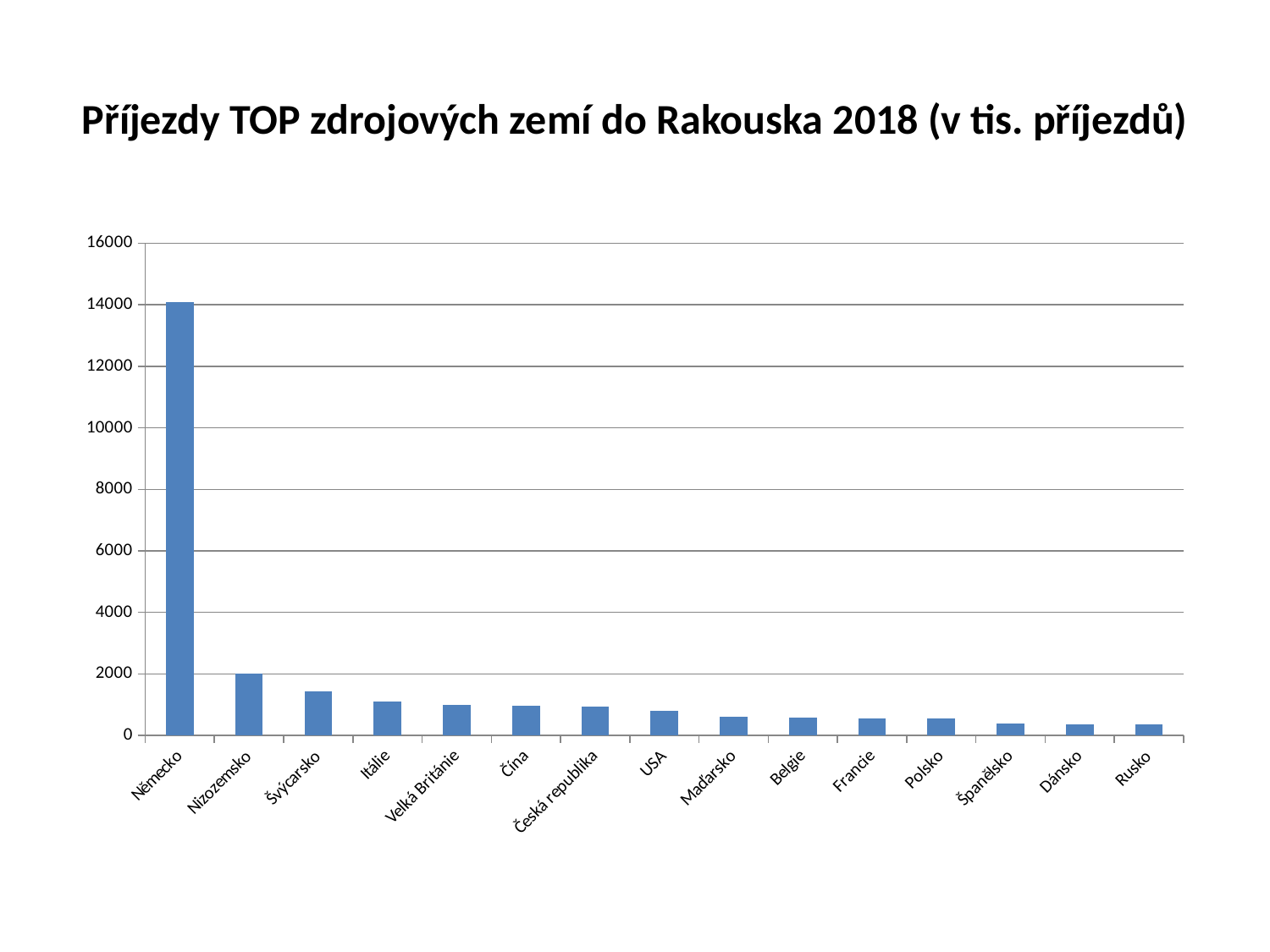
Is the value for Německo greater or less than 12000? greater Do the values generally rise or fall from left to right along the x axis? fall Which has a larger value, Švýcarsko or Itálie? Švýcarsko Is the value for Švýcarsko greater or less than 2000? less Is the value for Rusko greater or less than 2000? less Which has a larger value, Německo or Nizozemsko? Německo What is the title of the chart? Příjezdy TOP zdrojových zemí do Rakouska 2018 (v tis. příjezdů) Which has a larger value, Nizozemsko or Švýcarsko? Nizozemsko What kind of chart is shown on the slide? bar chart How many countries are shown on the x axis of the chart? 15 Which country has the highest value in the chart? Německo